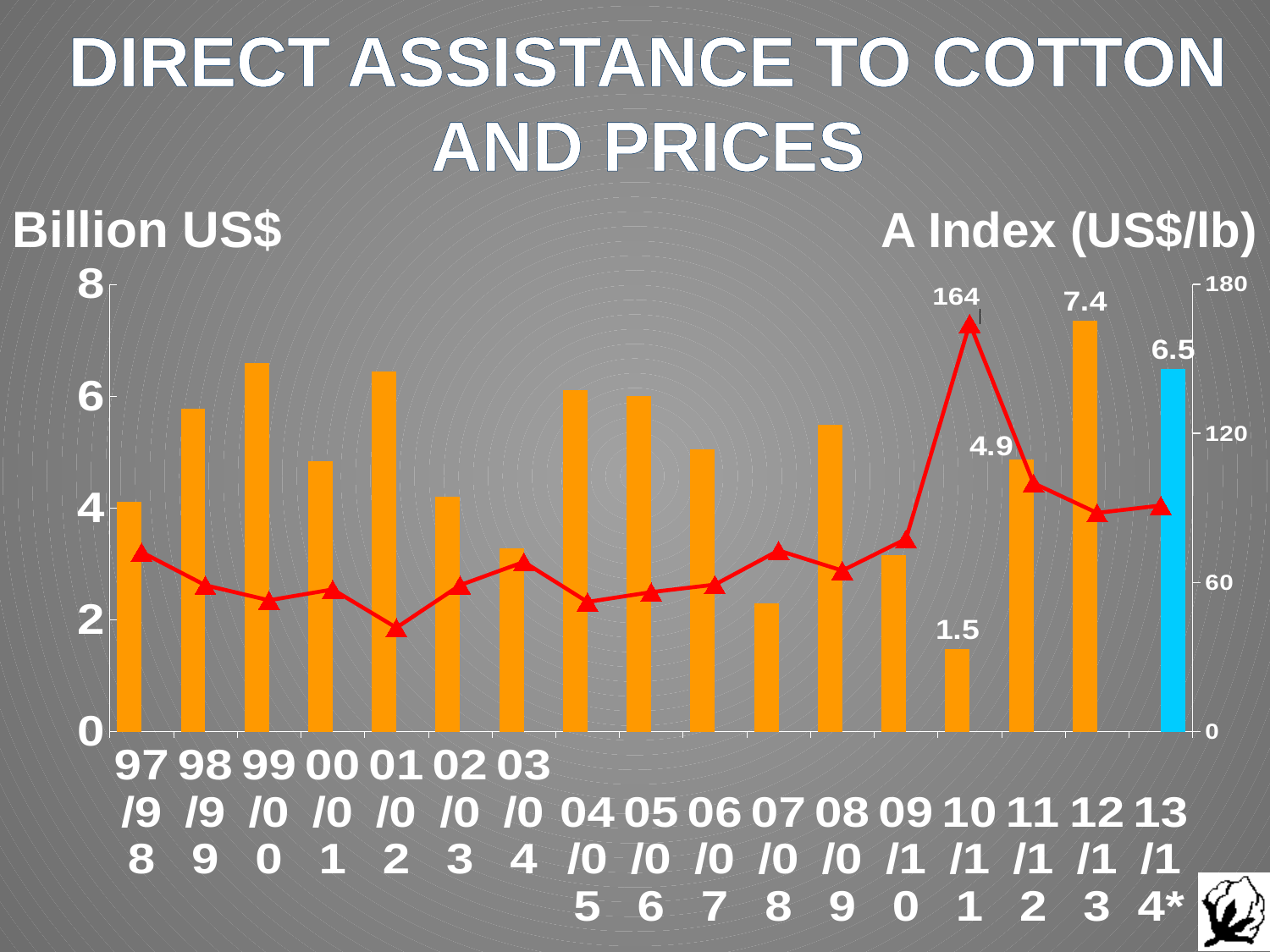
What is the value of the direct assistance bar for 10/11? 1.5 Which season has the highest direct assistance bar? 12/13 Which is larger, the bar for 10/11 or the bar for 11/12? 11/12 Which season has the lowest direct assistance bar? 10/11 What is the difference between the bar values for 12/13 and 10/11? 5.9 How many seasons are shown on the x axis? 17 What is the value of the direct assistance bar for 12/13? 7.4 What kind of chart is shown on the slide? Combination bar and line chart Is the direct assistance bar for 07/08 greater or less than 4? less What is the value of the bar for 13/14*? 6.5 What is the A Index value labelled at its peak in 10/11? 164 What is the value of the bar for 11/12? 4.9